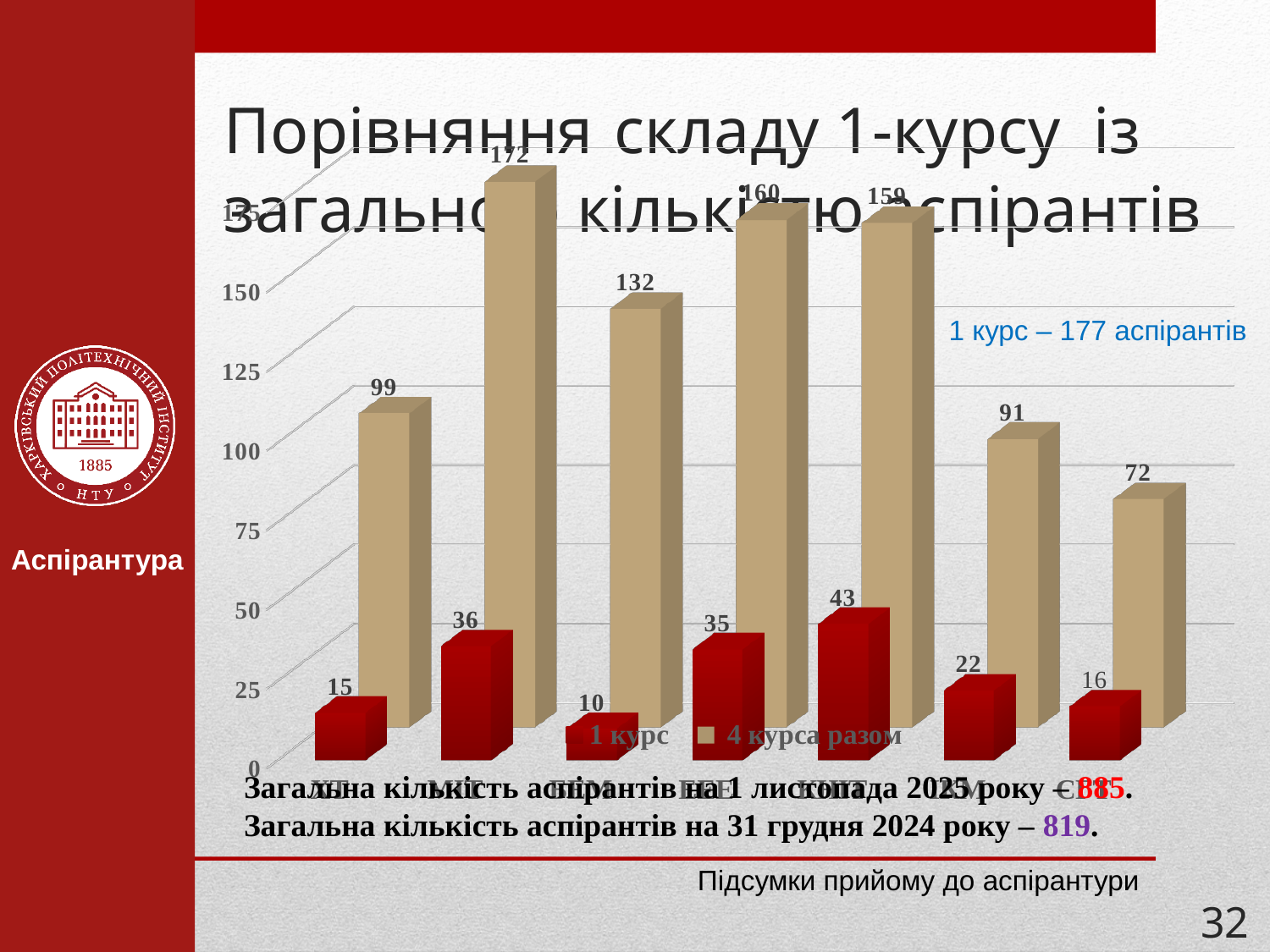
What is the lowest value among the '4 курса разом' bars? 72 What is the highest value among the '1 курс' bars? 43 How many series does the chart legend list? 2 In the group where the '4 курса разом' bar is 172, what is the '1 курс' value? 36 What is the difference between the highest and lowest '1 курс' values? 33 According to the annotation on the chart, how many aspirants are in 1 курс? 177 аспірантів How many category groups of bars are plotted in the chart? 7 What are the two series named in the chart legend? 1 курс and 4 курса разом What is the highest value among the '4 курса разом' bars? 172 What type of chart is shown on the slide? bar chart What is the difference between the highest and lowest '4 курса разом' values? 100 What is the lowest value among the '1 курс' bars? 10